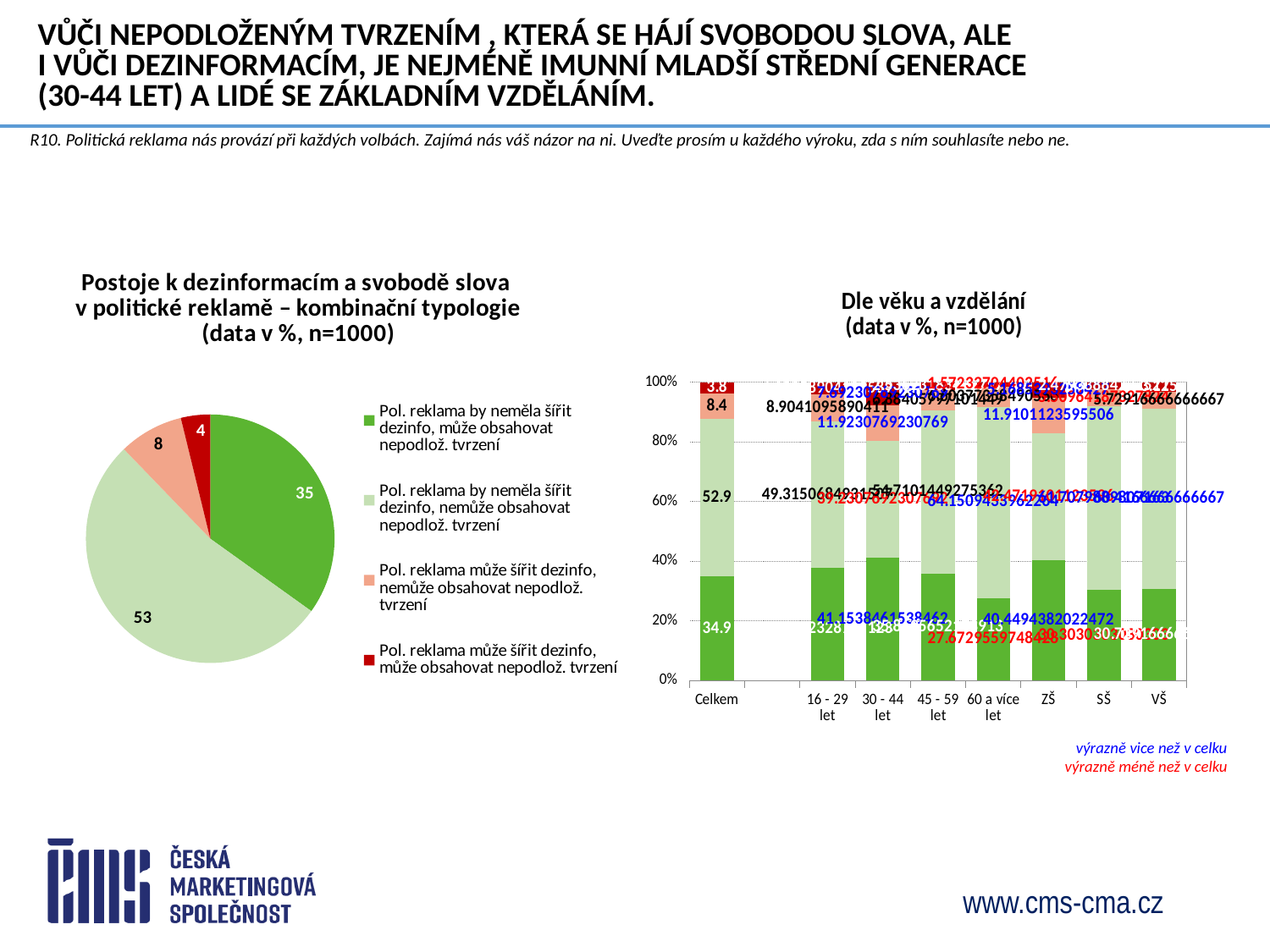
In the chart "Dle věku a vzdělání", is the dark green segment for "60 a více let" greater or less than 40%? less What type of chart is the chart titled "Dle věku a vzdělání"? stacked bar chart In the chart "Dle věku a vzdělání", what is the value of the bottom (dark green) segment for Celkem? 34.9 How many categories are shown on the x axis of the chart "Dle věku a vzdělání"? 8 In the chart "Dle věku a vzdělání", what is the value of the light green segment for Celkem? 52.9 In the pie chart, which is larger: the slice labelled 8 or the slice labelled 4? 8 In the pie chart, what is the difference between the two largest slices (53 and 35)? 18 In the chart "Dle věku a vzdělání", what is the value of the top (dark red) segment for Celkem? 3.8 What type of chart is the chart titled "Postoje k dezinformacím a svobodě slova v politické reklamě – kombinační typologie"? pie chart In the pie chart, what is the value of the smallest slice? 4 In the pie chart, what is the value of the largest slice? 53 How many slices does the pie chart have? 4